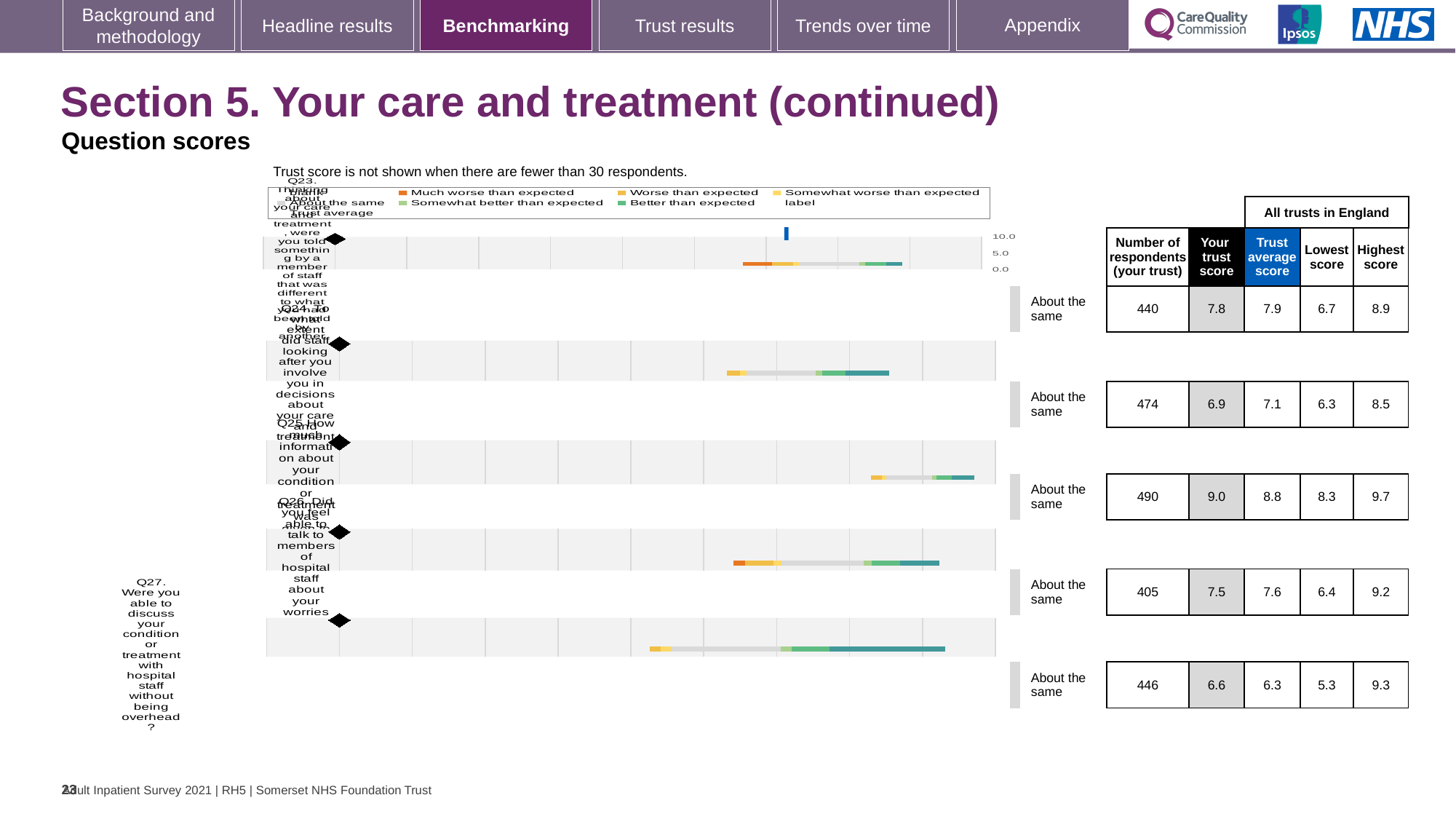
What kind of chart is used to show the question scores on this slide? Bar chart Which question has the highest 'Your trust score'? Q25 What is the lowest score among all trusts in England for Q26 (did you feel able to talk to members of hospital staff about your worries)? 6.4 For Q23, which is larger: 'Your trust score' or the trust average score? Trust average score Which question has the lowest 'Your trust score'? Q27 How many respondents (your trust) are shown for Q24 (to what extent did staff looking after you involve you in decisions about your care and treatment)? 474 What is the 'Your trust score' for Q23 (were you told something by a member of staff that was different to what you had been told by another)? 7.8 What is the trust average score for Q25 (how much information about your condition or treatment was given to you)? 8.8 What is the highest score among all trusts in England for Q27 (were you able to discuss your condition or treatment with hospital staff without being overheard)? 9.3 What benchmark category is shown next to each question's bar on this slide? About the same How many questions are shown in the benchmarking chart on this slide? 5 What is the difference between the trust average score and 'Your trust score' for Q24? 0.2